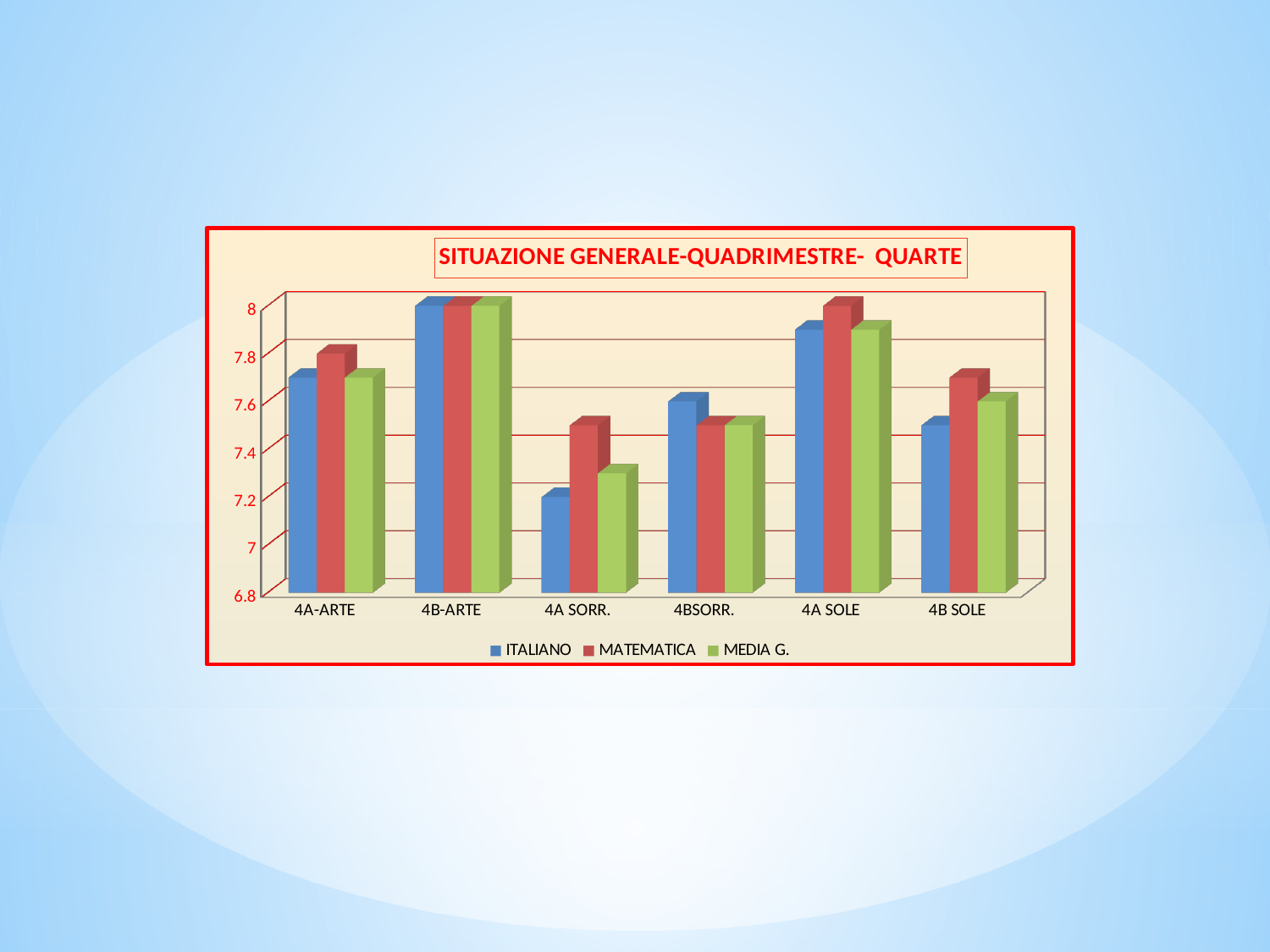
Is the MATEMATICA value for 4A SOLE greater or less than 7.8? greater Which category has the lowest MEDIA G. value? 4A SORR. Is the ITALIANO value for 4A SORR. greater or less than 7.4? less How many series does the legend list? 3 Which is larger: the ITALIANO value for 4A-ARTE or for 4B-ARTE? 4B-ARTE Is the MATEMATICA value for 4B SOLE greater or less than 7.6? greater What is the title of the chart? SITUAZIONE GENERALE-QUADRIMESTRE- QUARTE How many categories are shown on the x axis? 6 Which category has the lowest ITALIANO value? 4A SORR. For 4A SORR., which is larger: the ITALIANO value or the MATEMATICA value? MATEMATICA What kind of chart is shown on the slide? Bar chart